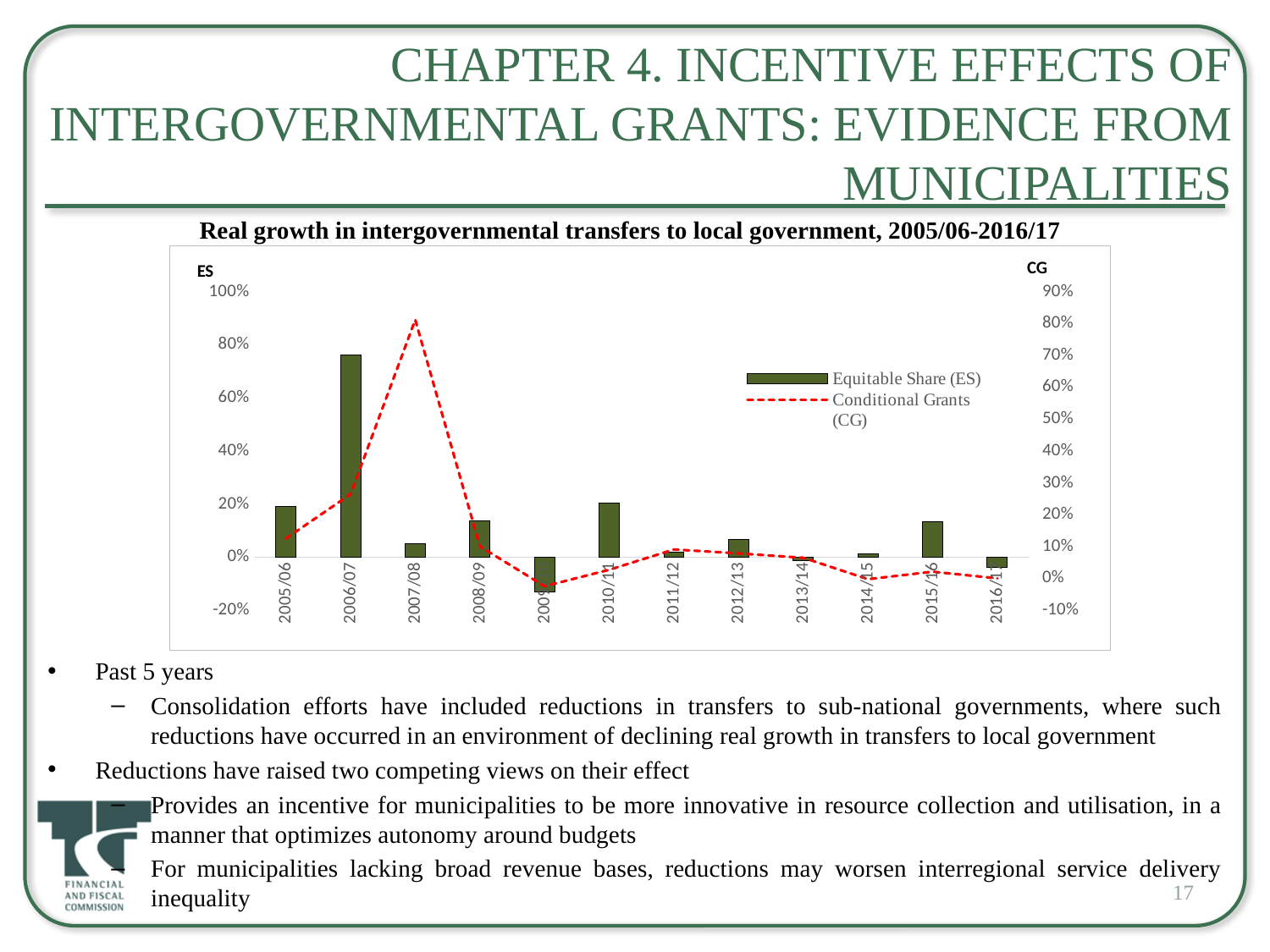
Is the Equitable Share (ES) value for 2006/07 greater or less than 60%? greater In which year is the Equitable Share (ES) bar highest? 2006/07 Does the Conditional Grants (CG) line rise or fall between 2007/08 and 2009/10? fall How many fiscal years are shown along the x axis? 12 What kind of chart is shown on the slide? A combined bar and line chart Is the Conditional Grants (CG) value for 2007/08 greater or less than 70% on the right-hand axis? greater In which year is the Equitable Share (ES) bar lowest? 2009/10 In which year does the Conditional Grants (CG) line reach its peak? 2007/08 Which series is drawn as a red dashed line? Conditional Grants (CG) How many series does the legend list? 2 What is the title of the chart? Real growth in intergovernmental transfers to local government, 2005/06-2016/17 Which year has the larger Equitable Share (ES) bar, 2006/07 or 2007/08? 2006/07